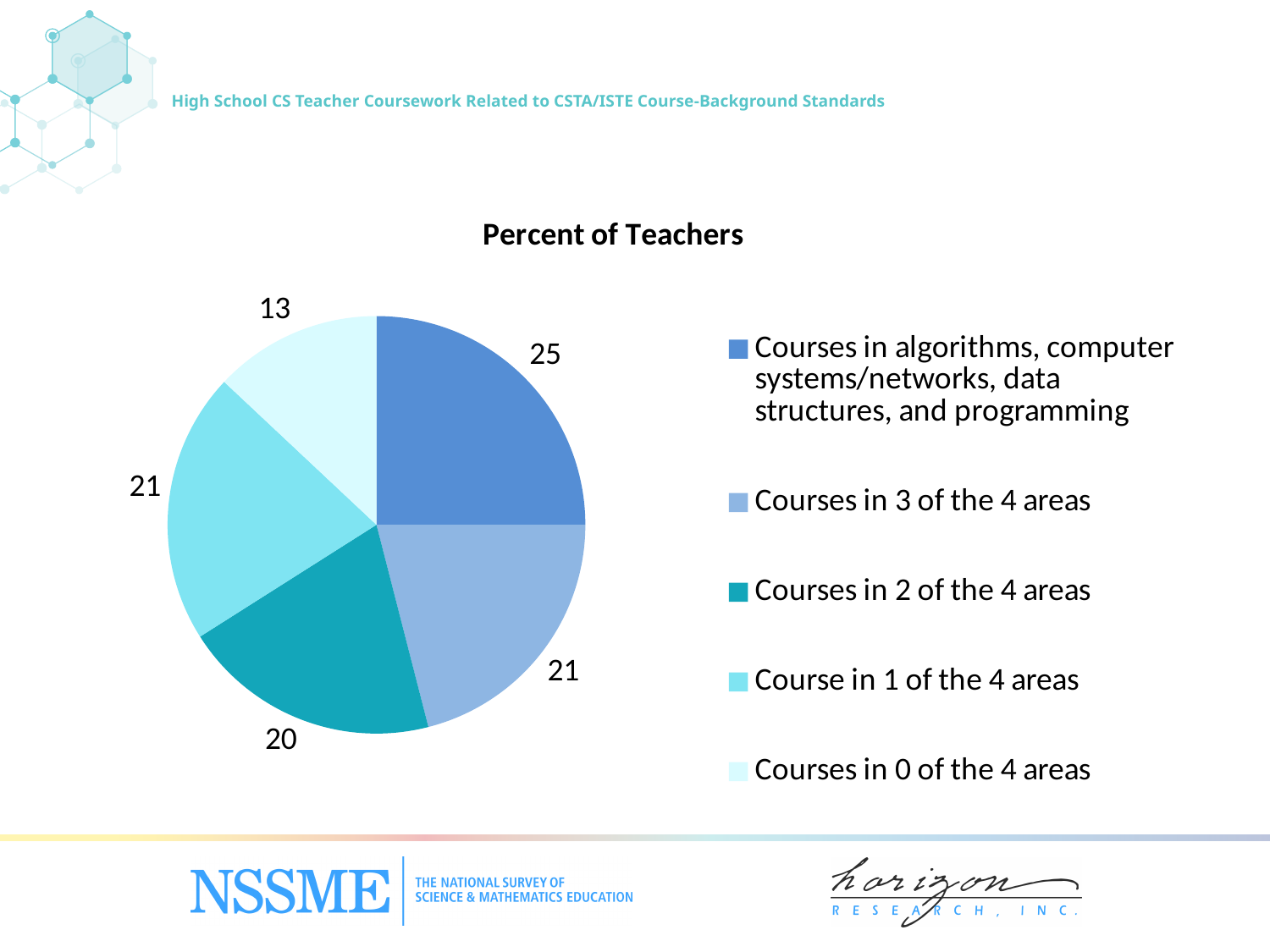
What percent of teachers had courses in 2 of the 4 areas? 20 Which category has the largest slice of the pie? Courses in algorithms, computer systems/networks, data structures, and programming What is the title of the chart? Percent of Teachers What percent of teachers had courses in algorithms, computer systems/networks, data structures, and programming? 25 How many entries does the legend list? 5 What is the difference between the percent of teachers with courses in all four areas and those with courses in 0 of the 4 areas? 12 Which category has the smallest slice of the pie? Courses in 0 of the 4 areas What percent of teachers had courses in 3 of the 4 areas? 21 Which is larger: the percent of teachers with courses in 2 of the 4 areas or with courses in 0 of the 4 areas? Courses in 2 of the 4 areas What percent of teachers had courses in 0 of the 4 areas? 13 What type of chart is shown on the slide? pie chart How many slices does the pie chart have? 5